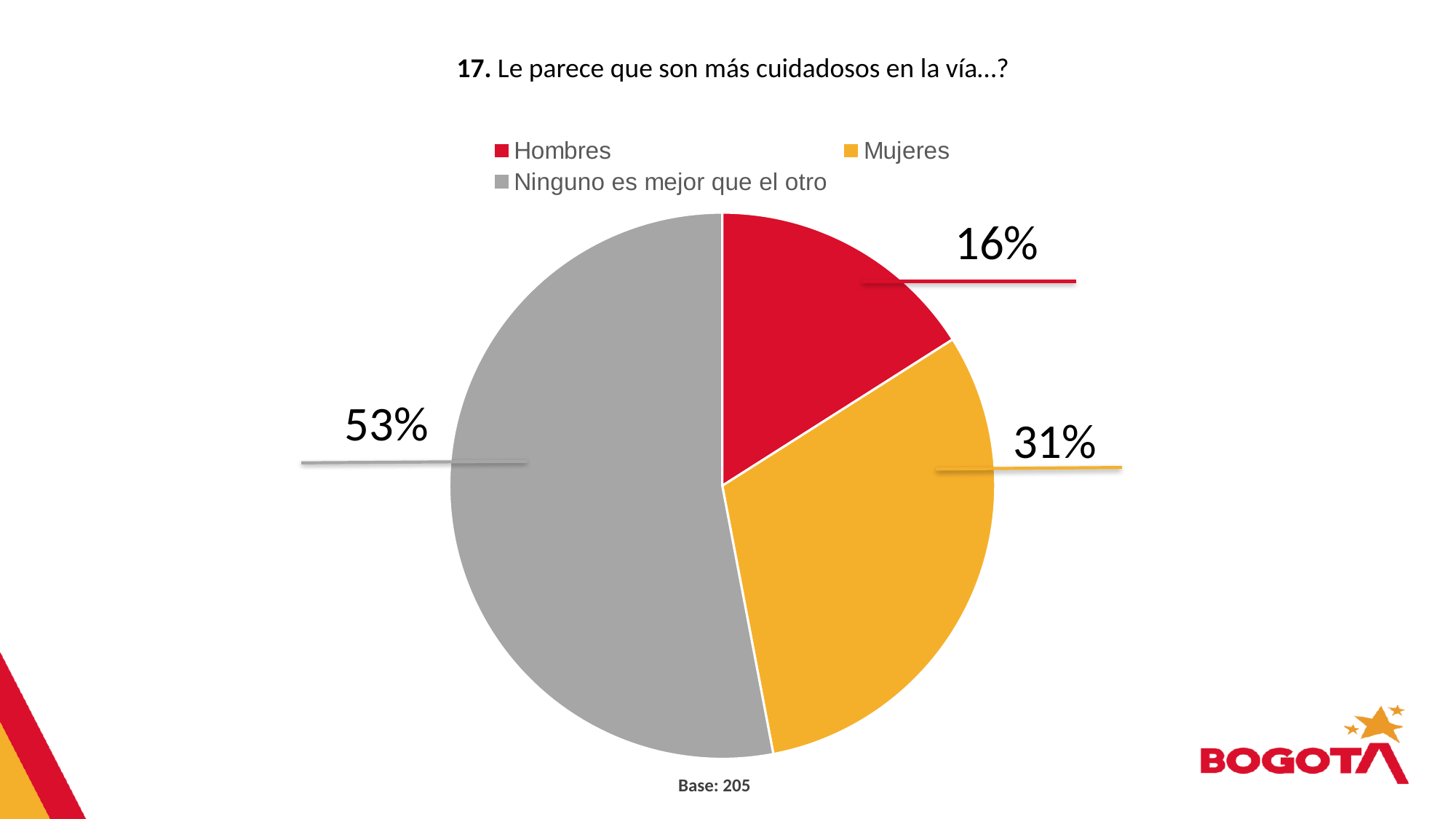
What base (number of respondents) is shown below the chart? 205 What is the difference in percentage points between Mujeres and Hombres? 15 What colour represents Mujeres in the pie chart? yellow/orange What percentage of the pie corresponds to 'Ninguno es mejor que el otro'? 53% What type of chart is shown on the slide? pie chart Which category has the largest share of the pie? Ninguno es mejor que el otro How many categories does the pie chart have? 3 What percentage of the pie corresponds to Hombres? 16% What percentage of the pie corresponds to Mujeres? 31% What is the difference in percentage points between 'Ninguno es mejor que el otro' and Mujeres? 22 Which category has the smallest share of the pie? Hombres Which is larger, the share for Mujeres or the share for Hombres? Mujeres